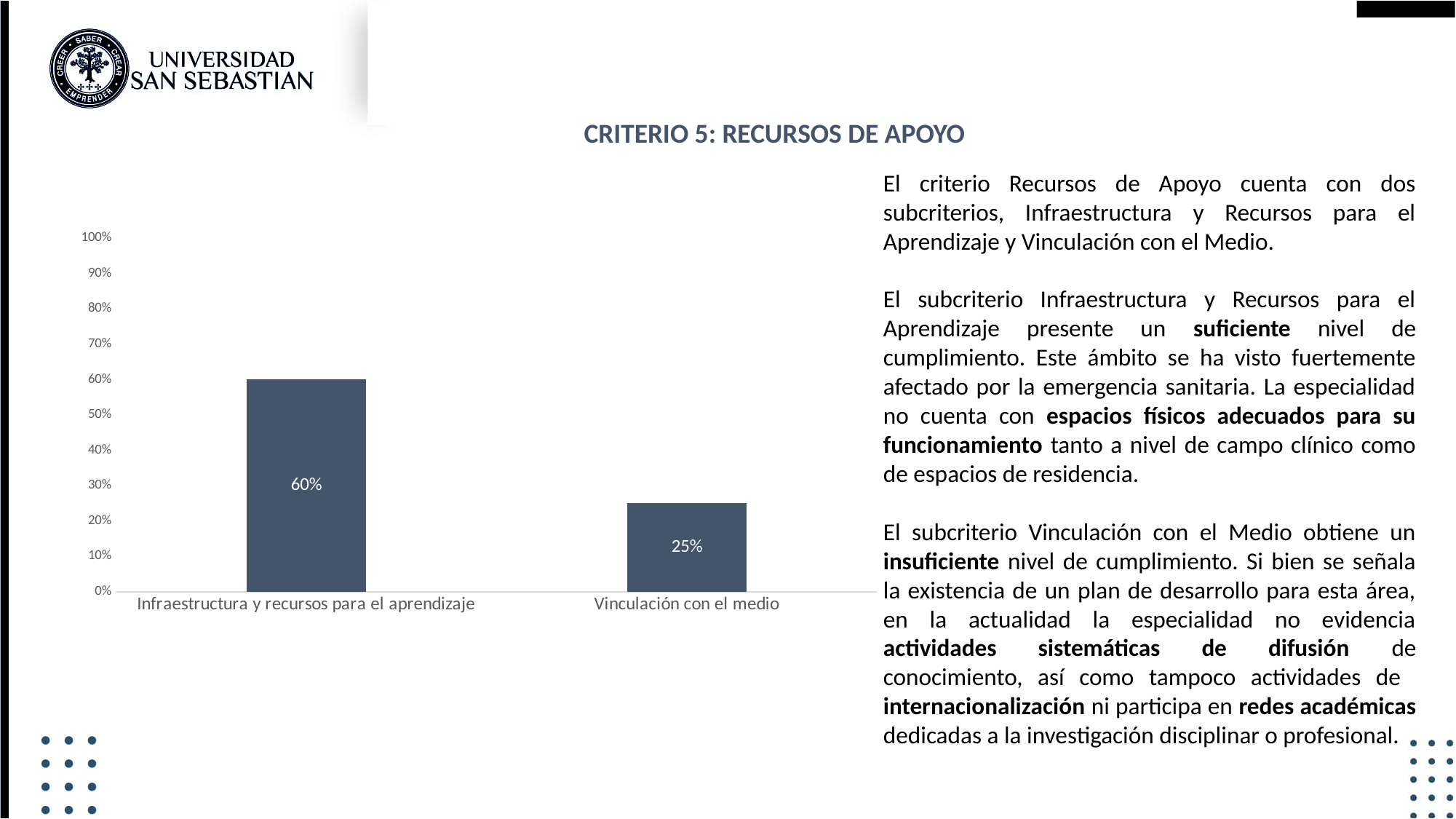
What is the title of the slide above the chart? CRITERIO 5: RECURSOS DE APOYO What is the value for Infraestructura y recursos para el aprendizaje? 60% Is the value for Vinculación con el medio greater or less than 30%? less What is the difference between the values for Infraestructura y recursos para el aprendizaje and Vinculación con el medio? 35% What is the maximum value shown on the vertical axis? 100% How many categories are shown in the chart? 2 Which is larger, the value for Infraestructura y recursos para el aprendizaje or the value for Vinculación con el medio? Infraestructura y recursos para el aprendizaje What kind of chart is shown on the slide? Bar chart Which category has the highest value? Infraestructura y recursos para el aprendizaje Which category has the lowest value? Vinculación con el medio What is the value for Vinculación con el medio? 25% Is the value for Infraestructura y recursos para el aprendizaje greater or less than 50%? greater